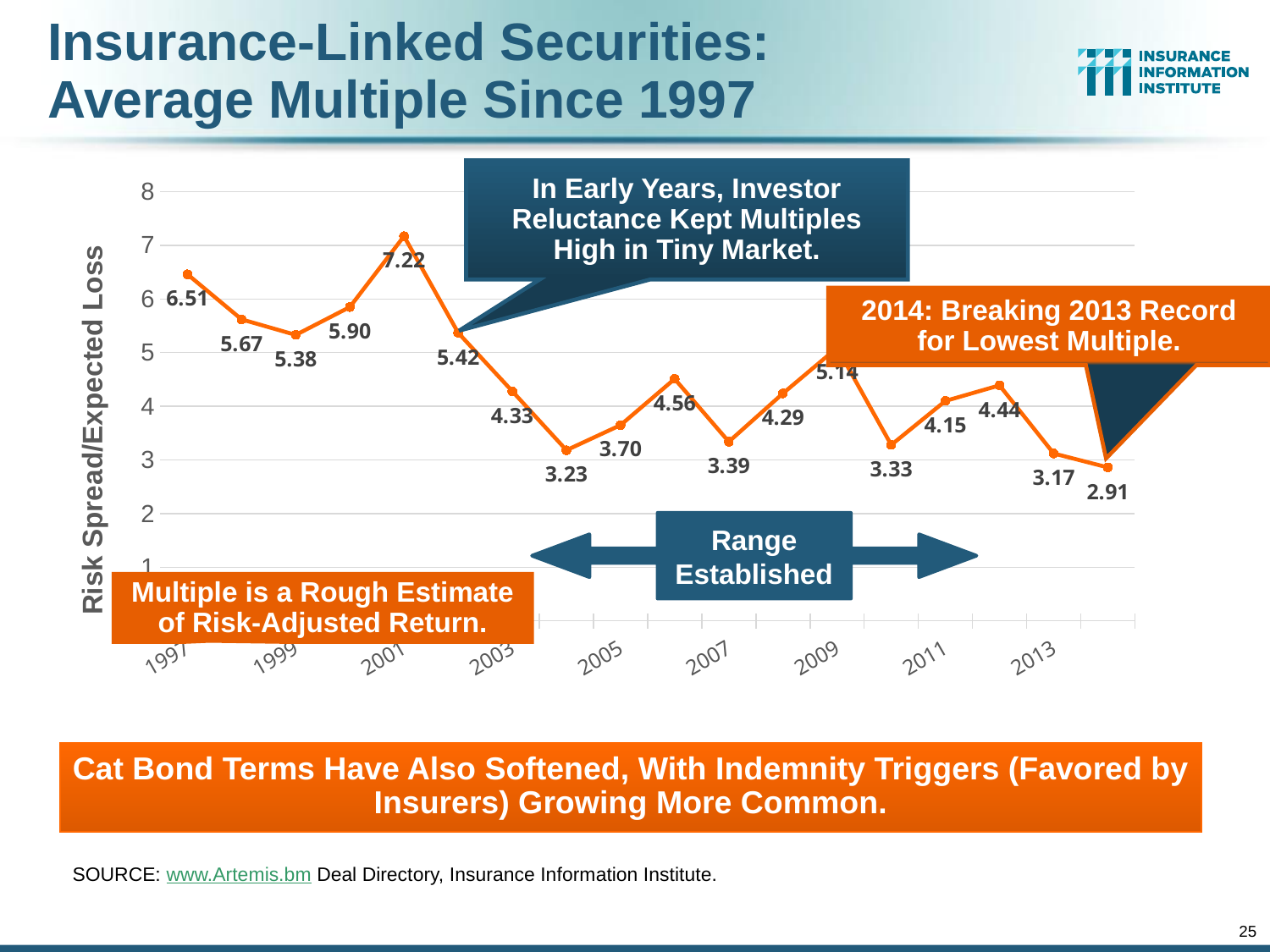
Which is larger, the value for 2005 or the value for 2007? 2005 What was the average multiple in 2013? 3.17 What is the lowest value plotted on the chart? 2.91 Which year had the highest average multiple? 2001 What was the average multiple in 2001? 7.22 Is the value for 2011 greater or less than 5? less What was the average multiple in 2009? 5.14 How many data points are plotted on the line? 18 What was the average multiple in 1997? 6.51 What is the difference between the 1997 value and the 2013 value? 3.34 What is the label on the vertical axis? Risk Spread/Expected Loss What type of chart is shown on the slide? line chart